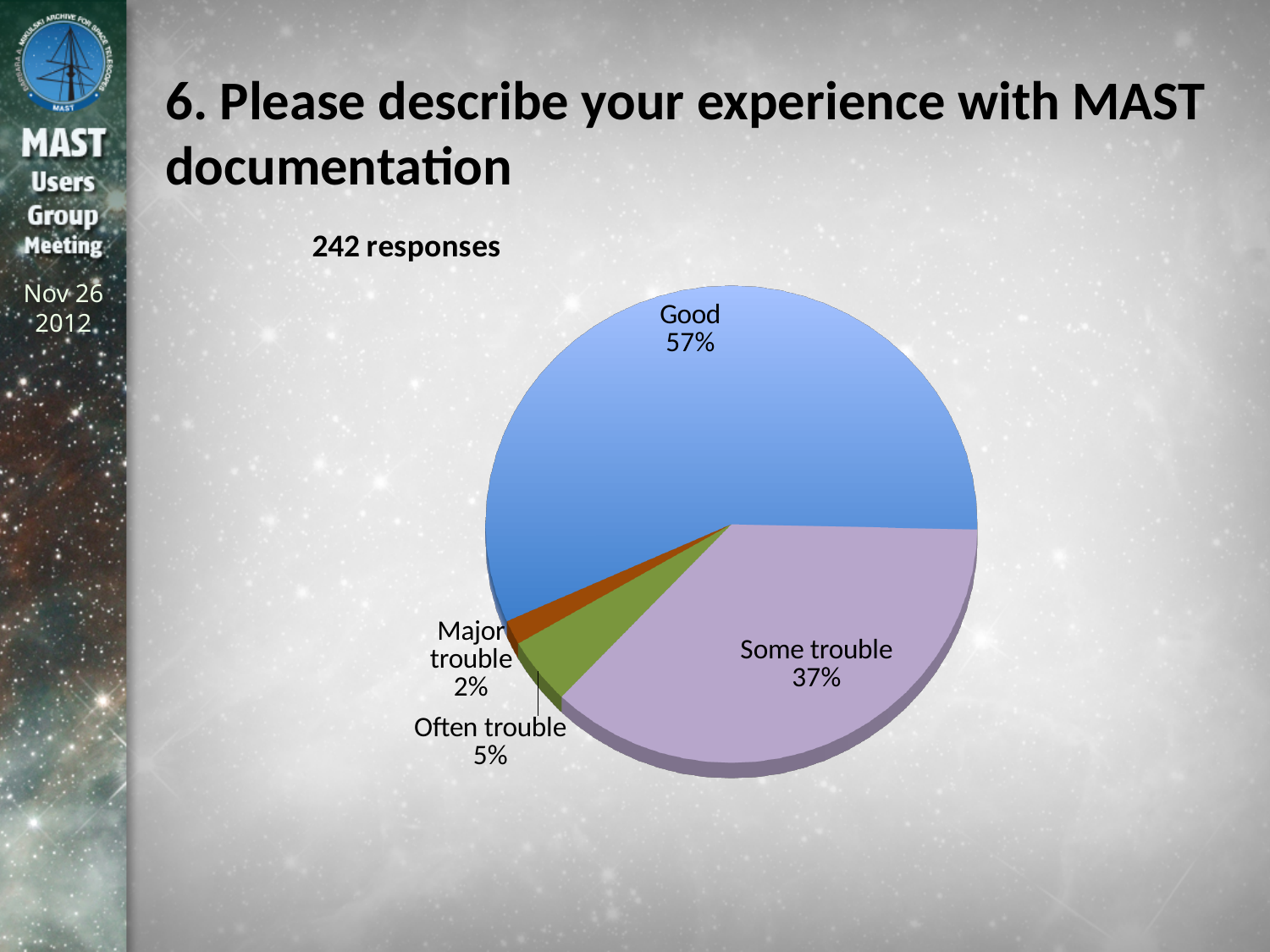
How many categories are shown in the pie chart? 4 Which category has the smallest slice of the pie? Major trouble What share of responses is labelled "Some trouble"? 37% Which category has the largest slice of the pie? Good What share of responses is labelled "Good"? 57% How many responses does the slide say the chart is based on? 242 responses What share of responses is labelled "Often trouble"? 5% What is the difference in percentage points between the "Good" and "Some trouble" slices? 20 Which slice is larger, "Often trouble" or "Major trouble"? Often trouble What colour is the "Some trouble" slice? Purple What kind of chart is shown on the slide? Pie chart